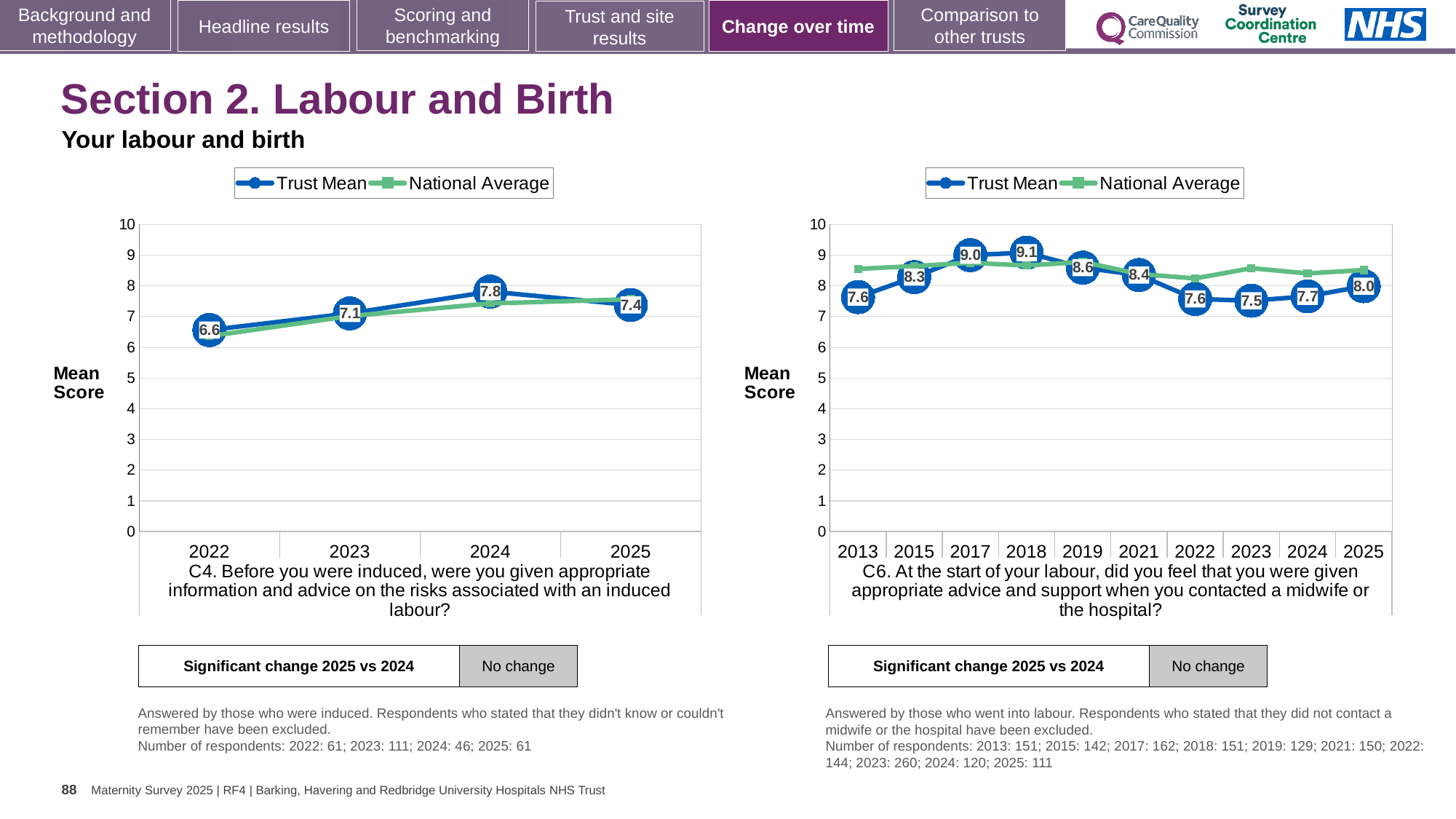
How many series does the legend of the C6 chart (right) list? 2 In the C4 chart (left), what is the difference between the Trust Mean for 2024 and 2022? 1.2 In the C6 chart (right), which year has the highest Trust Mean? 2018 In the C4 chart (left), how many years are shown on the x axis? 4 In the C4 chart (left), which year has the highest Trust Mean? 2024 In the C6 chart (right), which year has the lowest Trust Mean? 2023 In the C6 chart (right), how many years are shown on the x axis? 10 In the C6 chart (right), is the Trust Mean for 2017 or 2022 larger? 2017 In the C4 chart (left), what is the Trust Mean for 2022? 6.6 What kind of chart is the C4 chart (left)? Line chart In the C4 chart (left), what is the Trust Mean for 2024? 7.8 In the C6 chart (right), what is the Trust Mean for 2018? 9.1